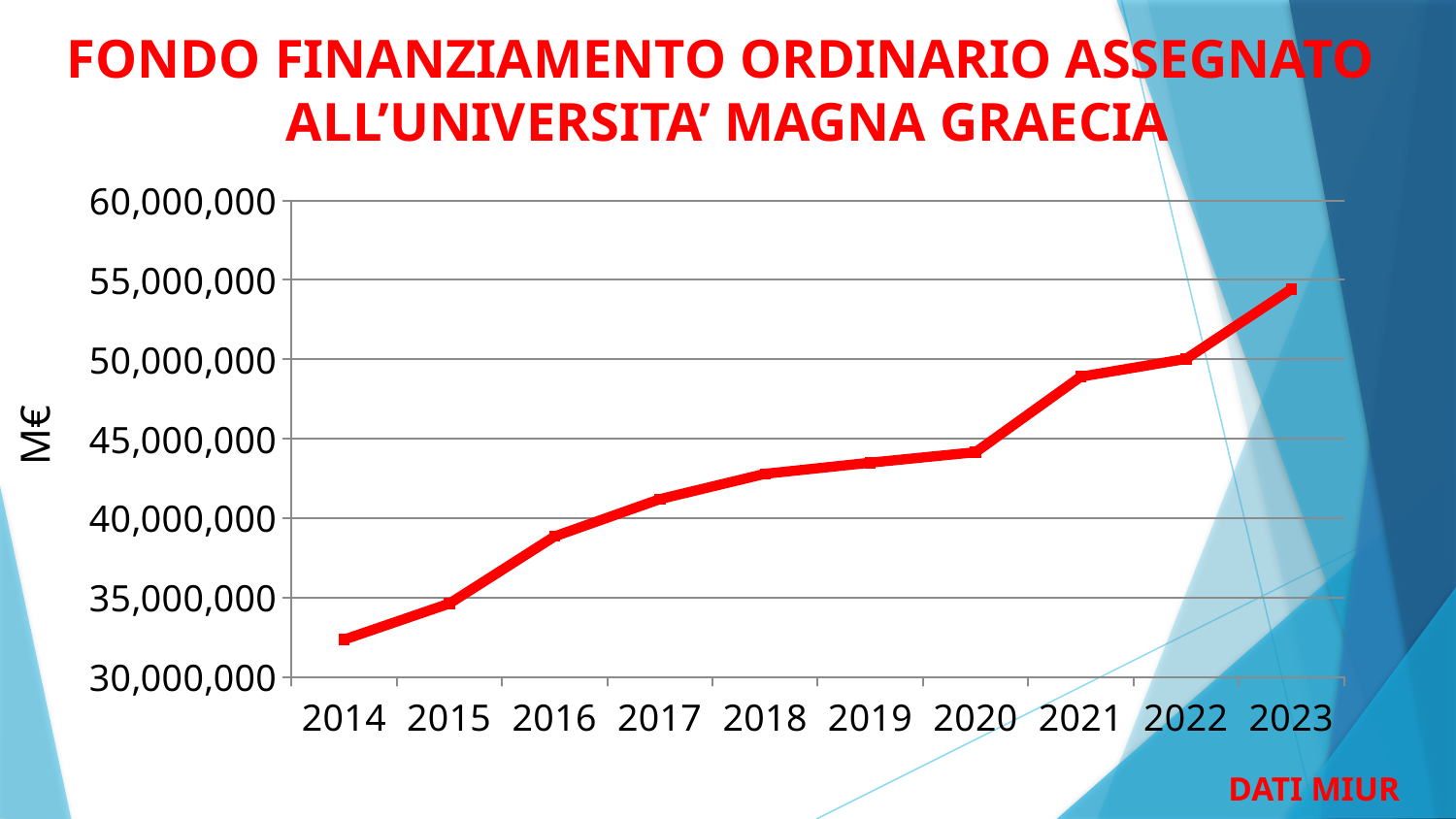
What is the label on the vertical axis? M€ What source is cited at the bottom right of the slide? DATI MIUR How many years are plotted along the x axis? 10 Is the value for 2014 greater or less than 35,000,000? less Is the value for 2023 greater or less than 50,000,000? greater Which year has the larger value, 2017 or 2020? 2020 Do the values rise or fall from 2014 to 2023? rise What kind of chart is shown on the slide? line chart Which year has the highest value? 2023 Which year has the lowest value? 2014 Is the value for 2021 greater or less than 45,000,000? greater